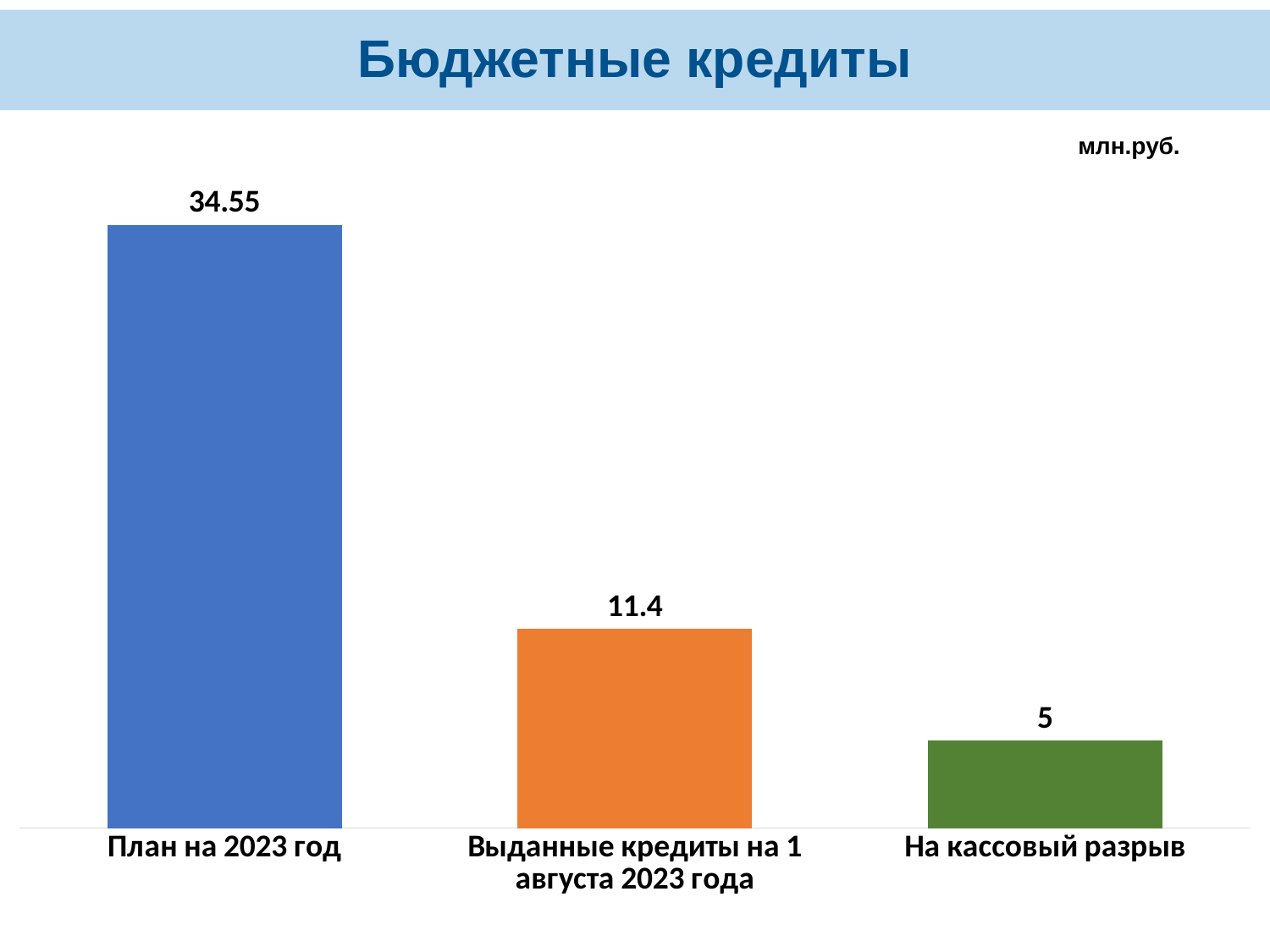
What is the difference between "Выданные кредиты на 1 августа 2023 года" and "На кассовый разрыв"? 6.4 Which category has the lowest value? На кассовый разрыв Which is larger: "Выданные кредиты на 1 августа 2023 года" or "На кассовый разрыв"? Выданные кредиты на 1 августа 2023 года How many categories are shown in the chart? 3 What is the value for "План на 2023 год"? 34.55 What is the title of the chart? Бюджетные кредиты What kind of chart is shown on the slide? Bar chart What is the value for "На кассовый разрыв"? 5 What is the difference between "План на 2023 год" and "Выданные кредиты на 1 августа 2023 года"? 23.15 Which category has the highest value? План на 2023 год Do the values rise or fall from left to right across the categories? Fall What is the value for "Выданные кредиты на 1 августа 2023 года"? 11.4